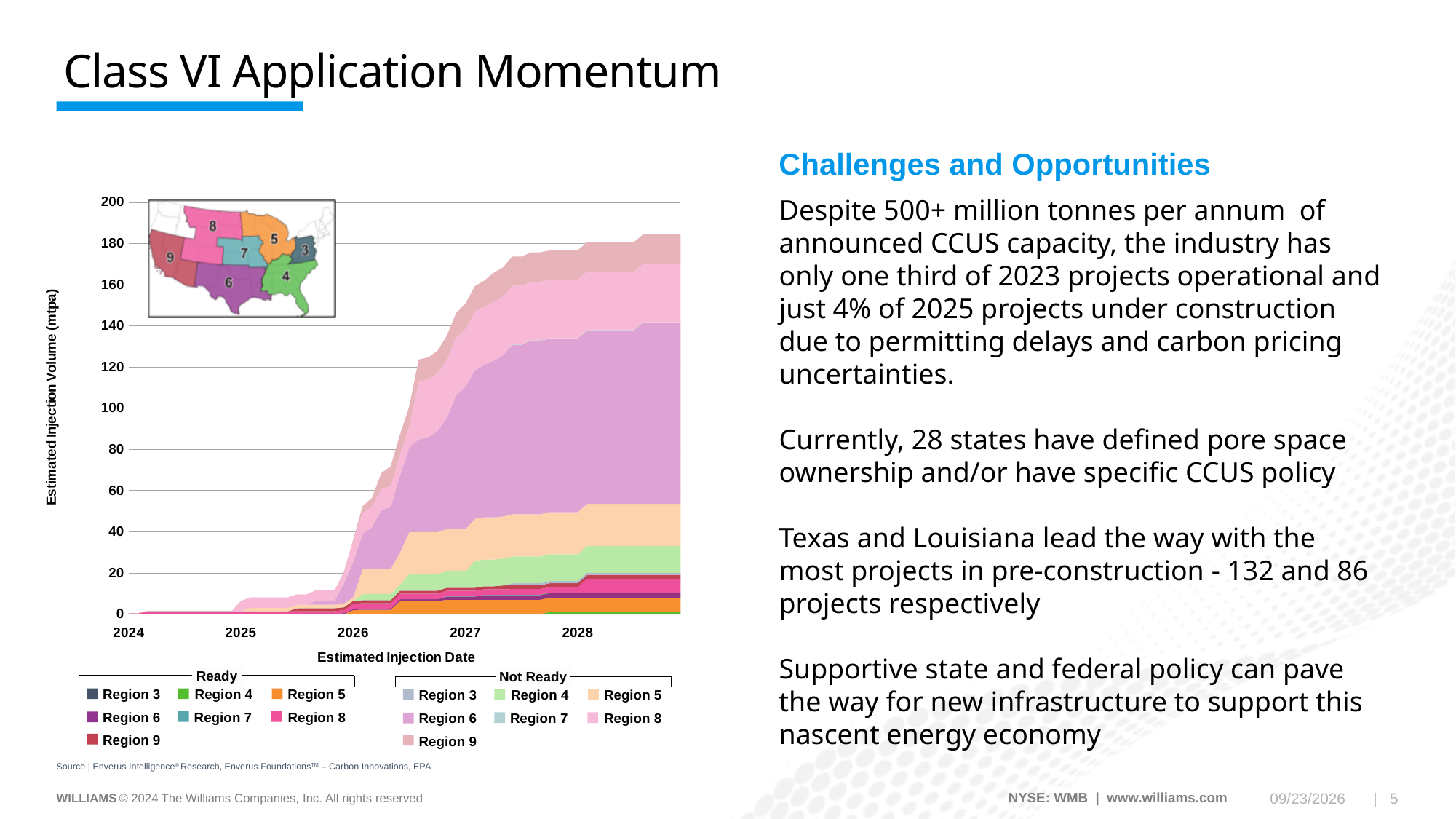
How many year labels are shown on the x axis? 5 What is the highest value shown on the y axis? 200 Is the total stacked estimated injection volume at the start of 2027 greater or less than 100? greater How many series does the chart's legend list in total across the Ready and Not Ready groups? 14 Does the total estimated injection volume rise or fall from 2024 to the end of the chart? Rise Is the total stacked estimated injection volume at the right end of the chart greater or less than 160? greater What is the title of the chart's y axis? Estimated Injection Volume (mtpa) Is the total stacked estimated injection volume at the start of 2026 greater or less than 60? less What is the title of the chart's x axis? Estimated Injection Date What kind of chart is shown on the slide? Stacked area chart How many series are listed under the 'Ready' group in the legend? 7